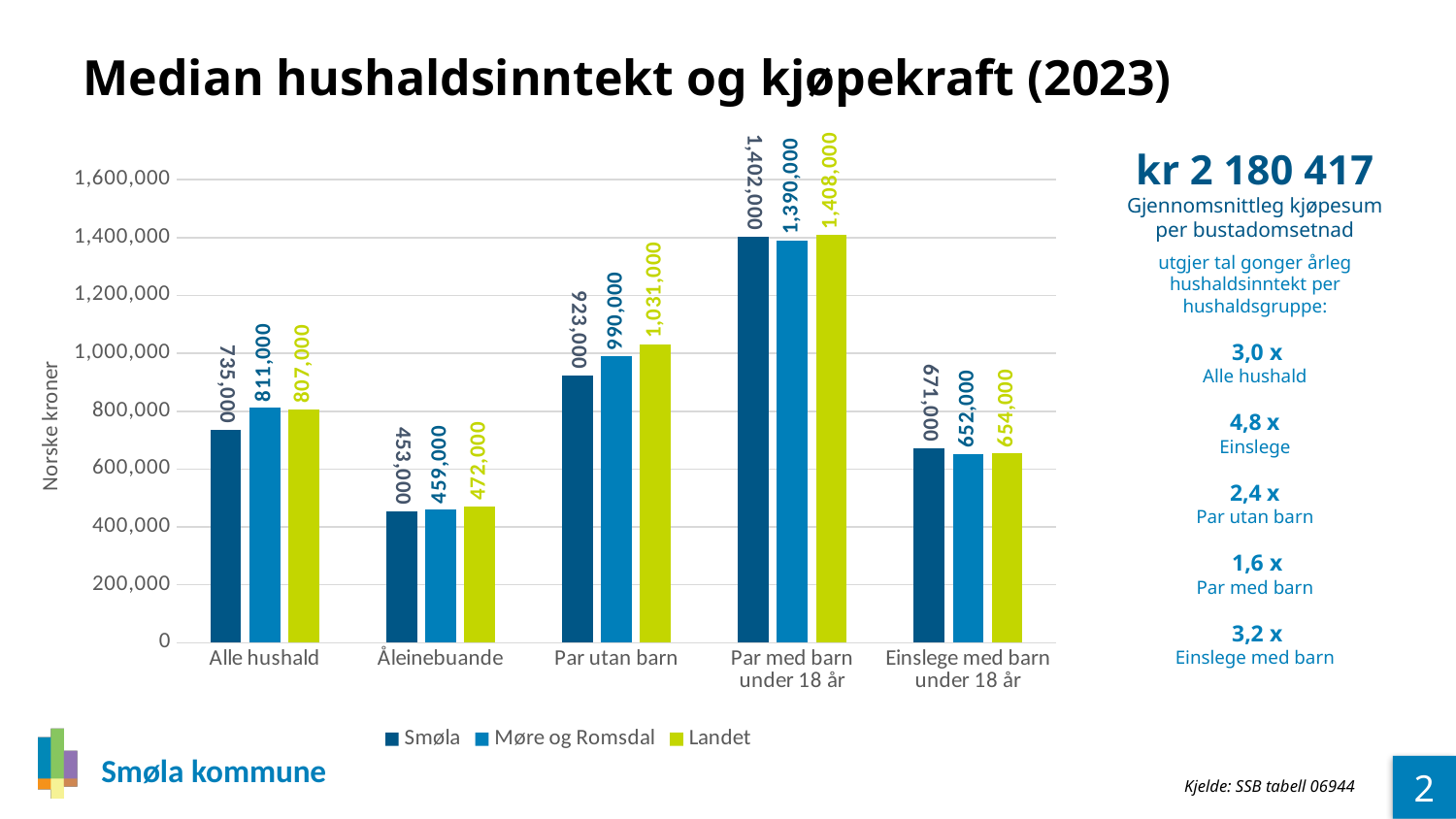
How many categories are shown on the x axis? 5 What is the label of the vertical axis? Norske kroner What is the value for Smøla in the Alle hushald category? 735,000 What is the difference between the Landet and Smøla values in the Par utan barn category? 108,000 Which category has the highest value for Smøla? Par med barn under 18 år In the Alle hushald category, which is larger: the value for Smøla or the value for Møre og Romsdal? Møre og Romsdal What is the difference between the Smøla and Møre og Romsdal values in the Einslege med barn under 18 år category? 19,000 What is the value for Landet in the Par utan barn category? 1,031,000 What is the value for Møre og Romsdal in the Åleinebuande category? 459,000 What kind of chart is shown on the slide? Bar chart Which category has the lowest value for Landet? Åleinebuande How many series does the legend list? 3